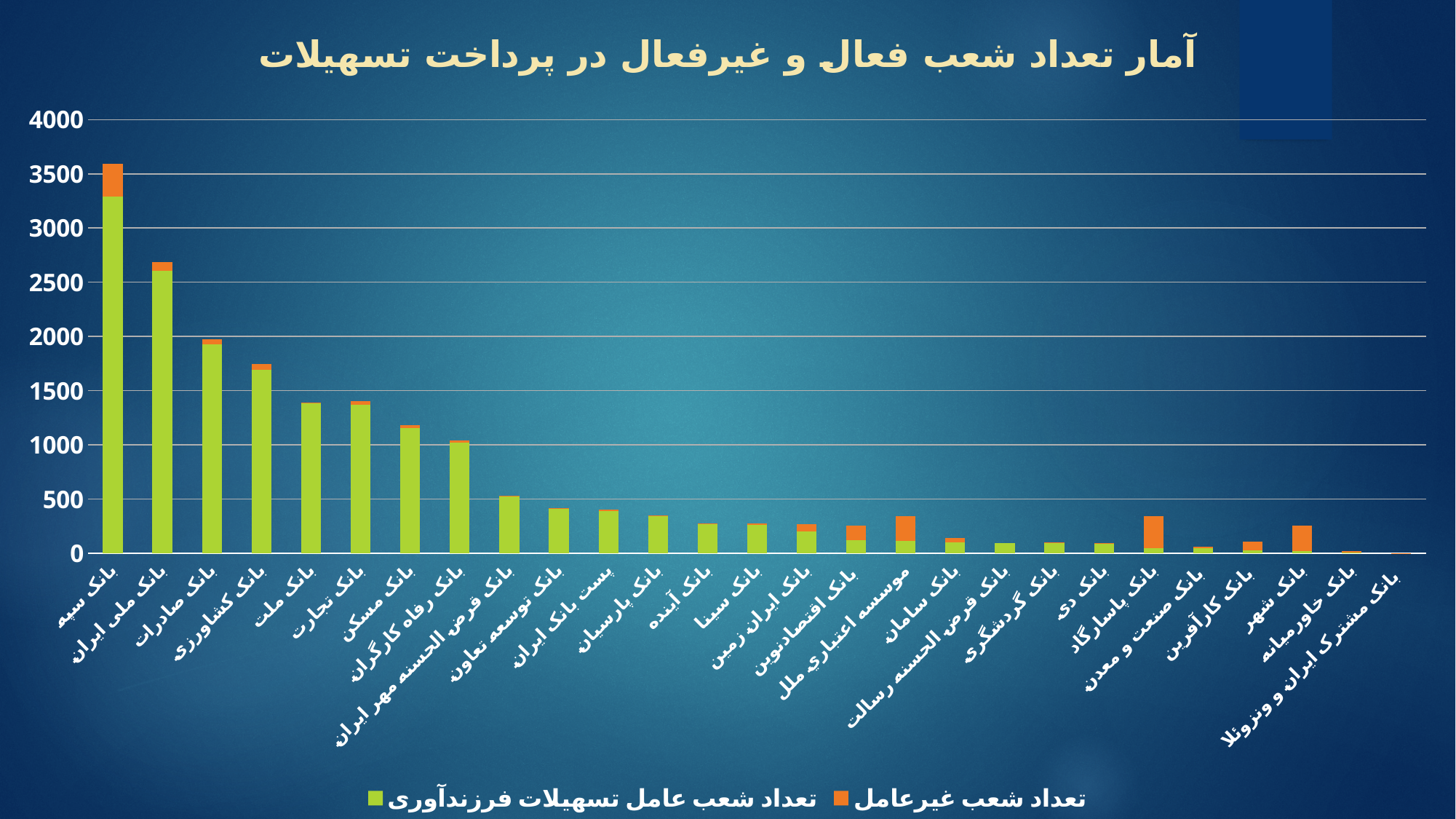
Do the bar heights generally rise or fall from left to right along the x axis? fall How many banks (categories) are shown on the x axis? 27 Which bank has the shortest bar? بانک مشترک ایران و ونزوئلا What kind of chart is shown on the slide? Stacked bar chart Which series is shown in orange according to the legend? تعداد شعب غیرعامل Which bar is taller, بانک صادرات or بانک کشاورزی? بانک صادرات Is the total bar for بانک ملت greater or less than 1500? less Is the total bar for بانک ملی ایران greater or less than 2500? greater Is the total bar for بانک سپه greater or less than 3000? greater How many series does the legend list? 2 Which bank has the tallest bar? بانک سپه